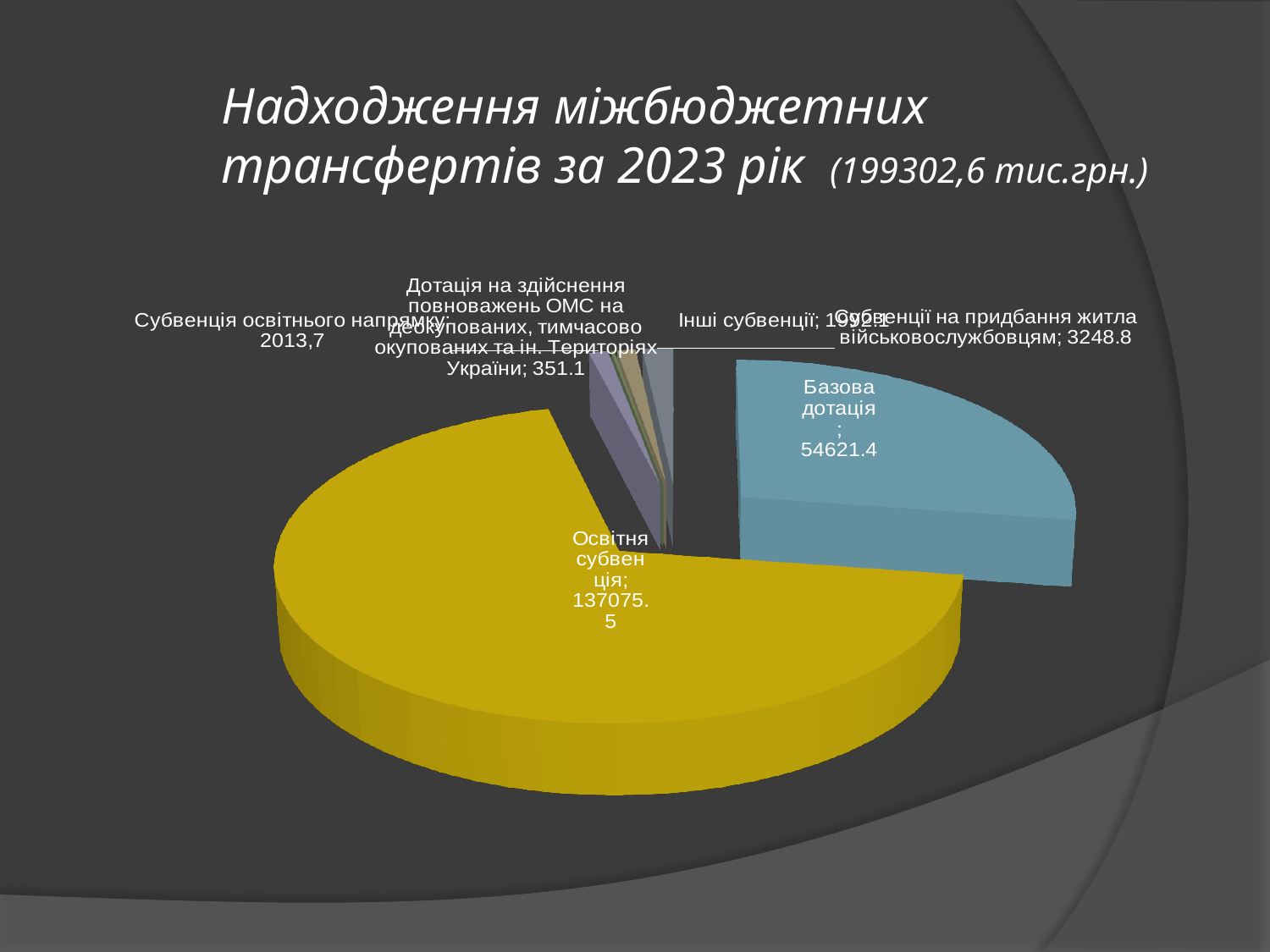
What total amount is given in the chart title? 199302,6 тис.грн. What is the value of the Базова дотація slice? 54621.4 How many slices does the pie chart have? 6 Which is larger, Базова дотація or Субвенції на придбання житла військовослужбовцям? Базова дотація What is the value shown for Дотація на здійснення повноважень ОМС на деокупованих, тимчасово окупованих та ін. територіях України? 351.1 What kind of chart is shown on the slide? Pie chart Which slice of the pie is the largest? Освітня субвенція What is the difference between the Освітня субвенція and Базова дотація values? 82454.1 What is the value of the Освітня субвенція slice? 137075.5 What is the value shown for Субвенції на придбання житла військовослужбовцям? 3248.8 Which slice of the pie is the smallest? Дотація на здійснення повноважень ОМС на деокупованих, тимчасово окупованих та ін. територіях України What is the value shown for Субвенція освітнього напрямку? 2013,7